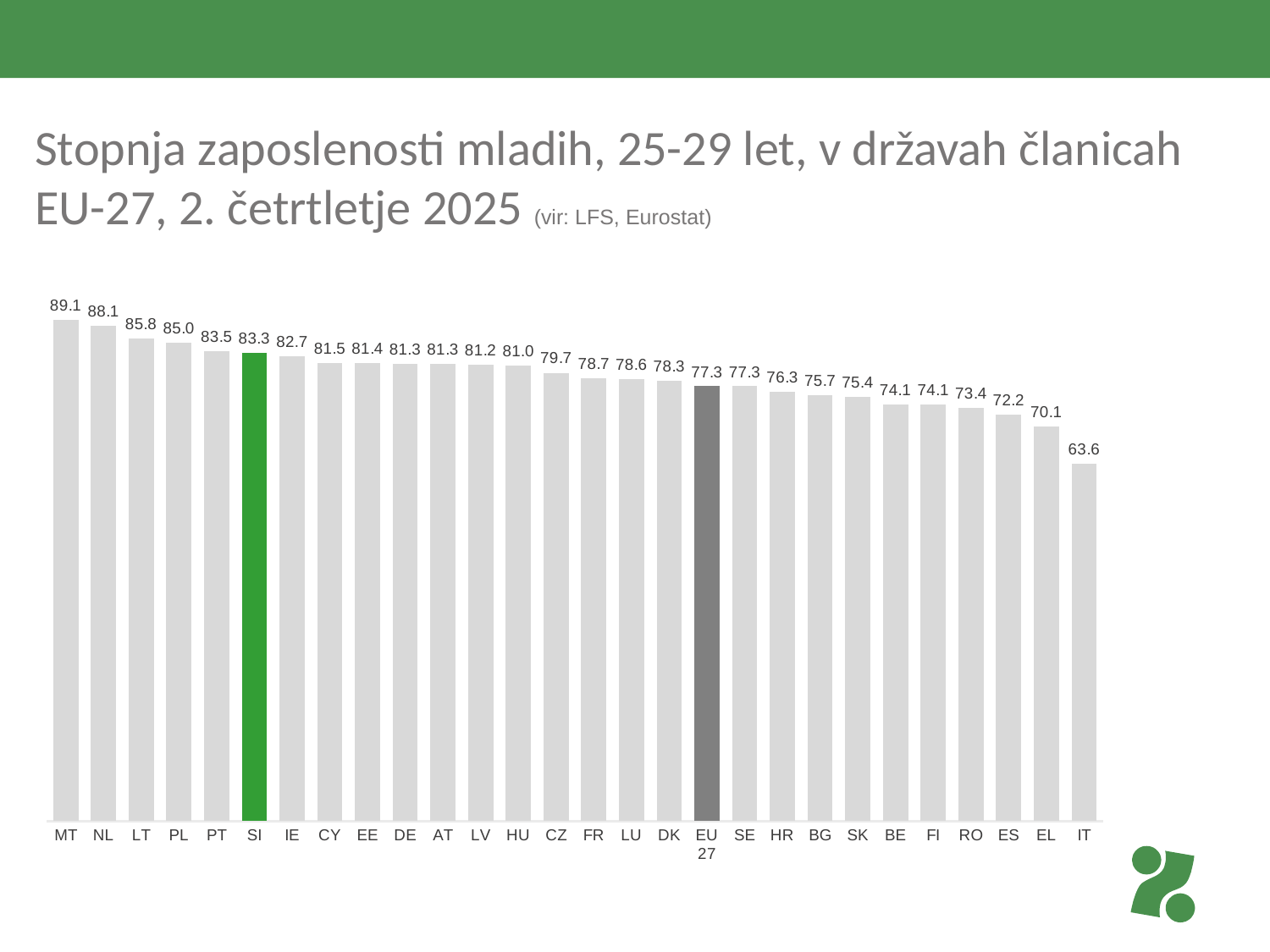
Which category has the lowest value? IT What is the difference between the values for SI and EU 27? 6.0 What is the value for HU? 81.0 Which is larger, the value for PL or the value for PT? PL What kind of chart is shown on the slide? Bar chart What is the value for EU 27? 77.3 Which category has the highest value? MT Which bar is coloured green? SI Do the values rise or fall from left to right along the x axis? Fall How many bars are shown in the chart? 28 What is the value for SI? 83.3 What is the difference between the values for MT and IT? 25.5